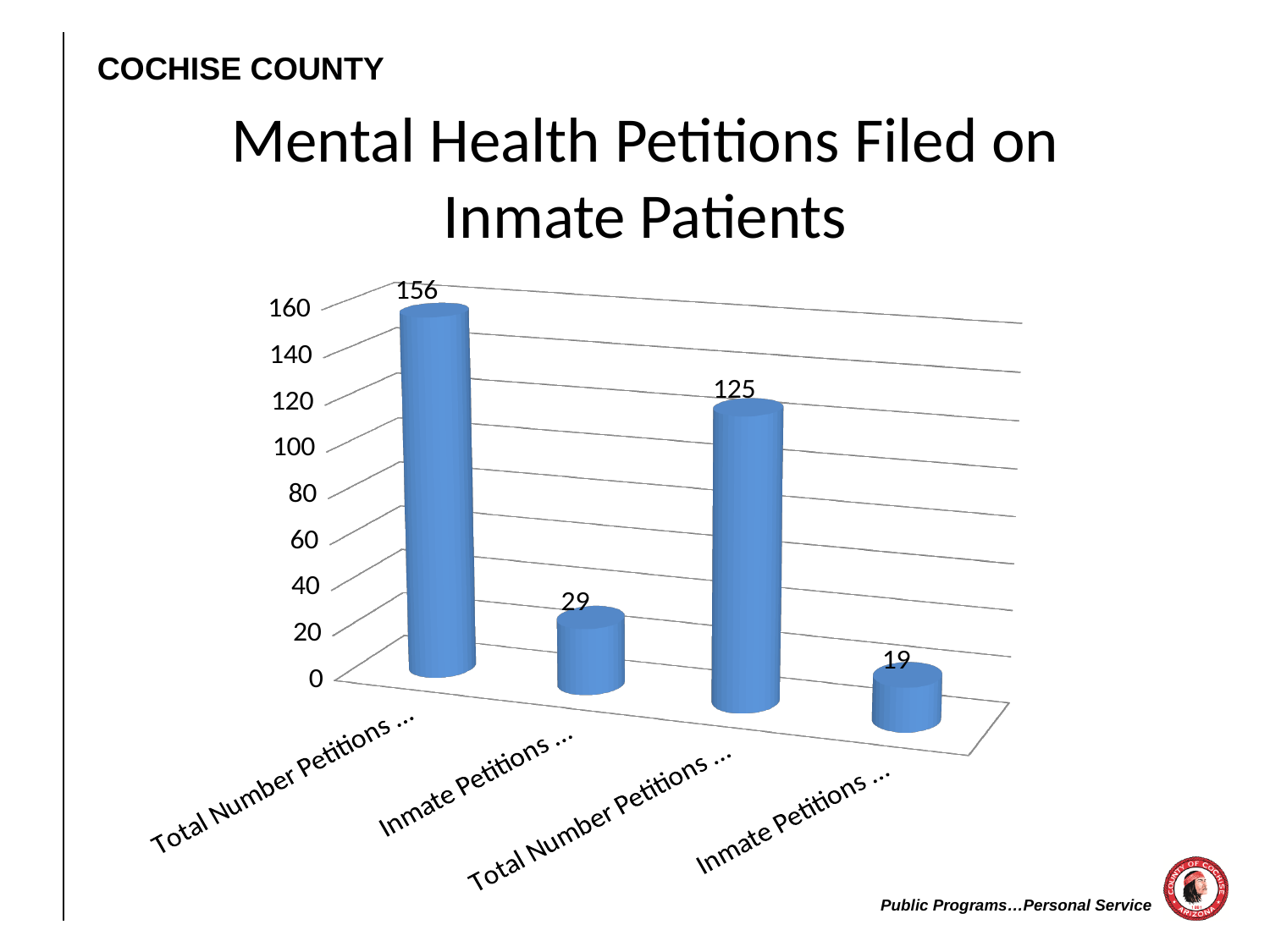
What is the value of the second bar from the left in the chart? 29 How many bars are plotted in the chart? 4 Which is larger, the second bar or the fourth bar? the second bar (29) What is the value of the third bar from the left in the chart? 125 Is the value of the third bar greater or less than 100? greater What is the value of the first (leftmost) bar in the chart? 156 What is the difference between the first bar (156) and the third bar (125)? 31 What is the value of the fourth (rightmost) bar in the chart? 19 Which bar has the lowest value in the chart? the fourth (rightmost) bar, 19 Which bar has the highest value in the chart? the first (leftmost) bar, 156 What type of chart is shown on the slide? bar chart What is the title of the chart? Mental Health Petitions Filed on Inmate Patients